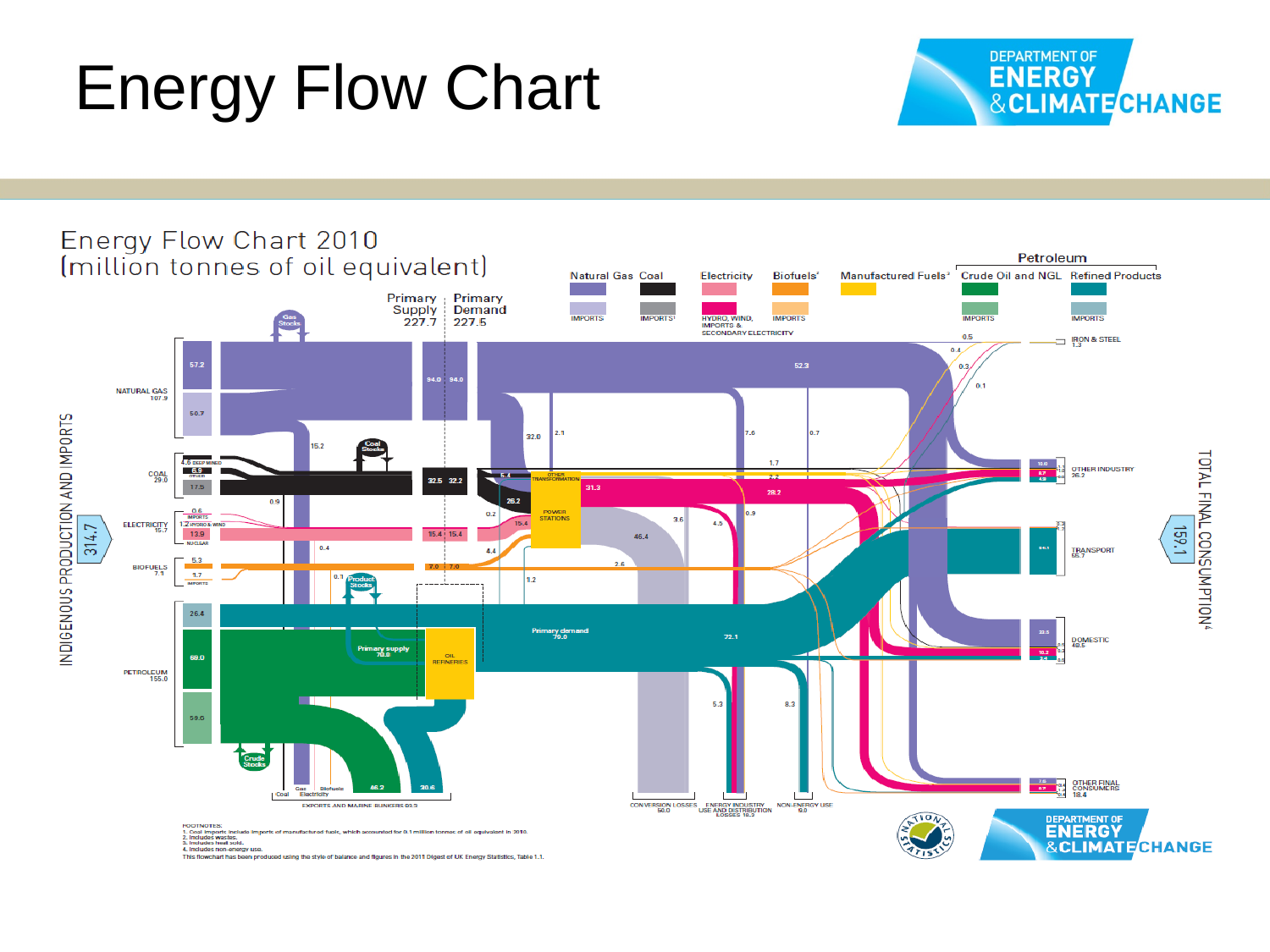
What is the difference between Primary Supply (227.7) and Primary Demand (227.5)? 0.2 What kind of chart is shown on the slide? Sankey flow chart What is the value shown for Petroleum among the indigenous production and imports sources? 155.0 Which final consumption sector has the largest value: Transport, Domestic or Other Industry? Transport What unit are the values in the chart expressed in? million tonnes of oil equivalent What is the total for Indigenous Production and Imports on the left of the chart? 314.7 What is the Total Final Consumption value on the right of the chart? 159.1 What is the value shown for Natural Gas among the indigenous production and imports sources? 107.9 What is the value shown for Primary Supply? 227.7 What is the title of the chart on the slide? Energy Flow Chart 2010 What is the value shown for Primary Demand? 227.5 Which is larger, the Transport final consumption (55.7) or the Domestic final consumption (48.5)? Transport